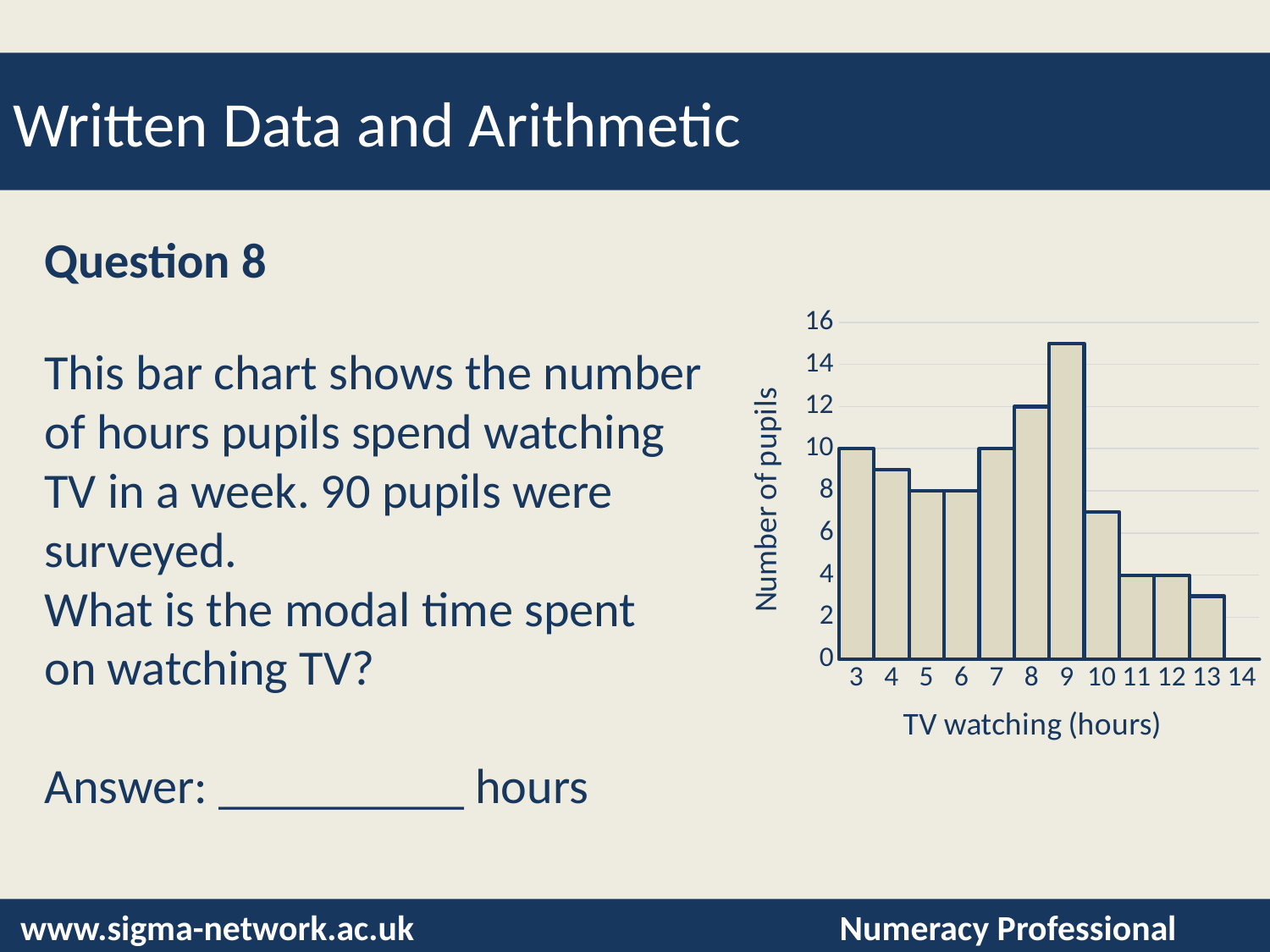
How many bars does the chart have? 11 Which has more pupils: 7 hours or 12 hours of TV watching? 7 hours What is the number of pupils for 3 hours of TV watching? 10 What type of chart is shown on the slide? bar chart What is the difference in number of pupils between 8 hours and 3 hours of TV watching? 2 Is the number of pupils for 10 hours greater or less than 8? less What is the number of pupils for 11 hours of TV watching? 4 Is the number of pupils for 9 hours greater or less than 14? greater What is the number of pupils for 8 hours of TV watching? 12 Which TV watching time (hours) has the lowest number of pupils? 13 Which TV watching time (hours) has the highest number of pupils? 9 What is the label on the x axis of the chart? TV watching (hours)